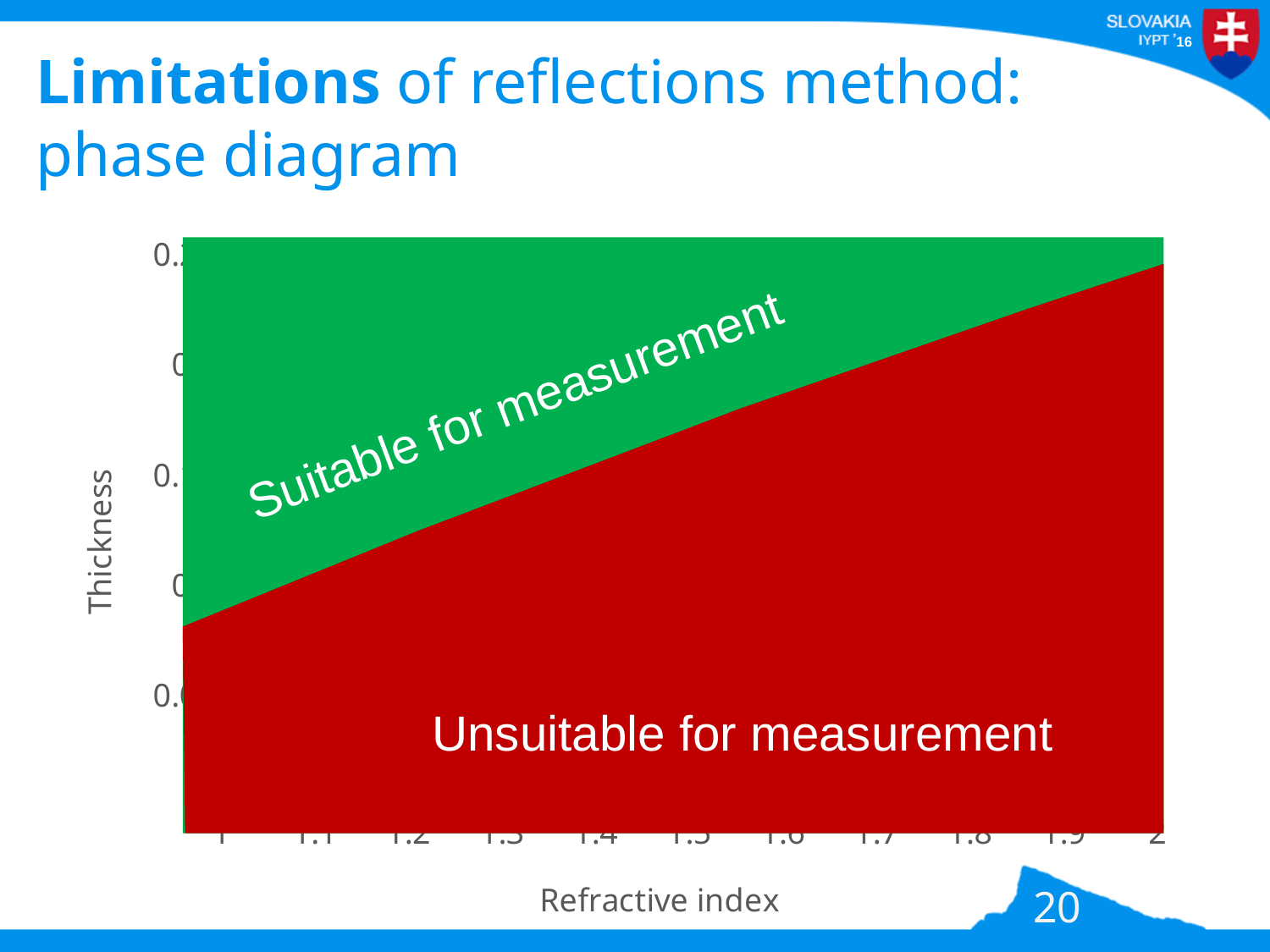
What does the green region of the chart represent? Suitable for measurement Which region occupies the top of the chart, suitable or unsuitable for measurement? Suitable for measurement Does the boundary between the suitable and unsuitable regions rise or fall as the refractive index increases? rise What is the highest refractive index value shown on the x axis? 2 How many regions are shown in the phase diagram? 2 Which region is larger at a refractive index of 2: suitable or unsuitable for measurement? Unsuitable for measurement What is the lowest refractive index value shown on the x axis? 1 What is the label on the x axis of the chart? Refractive index What is the label on the y axis of the chart? Thickness What does the red region of the chart represent? Unsuitable for measurement